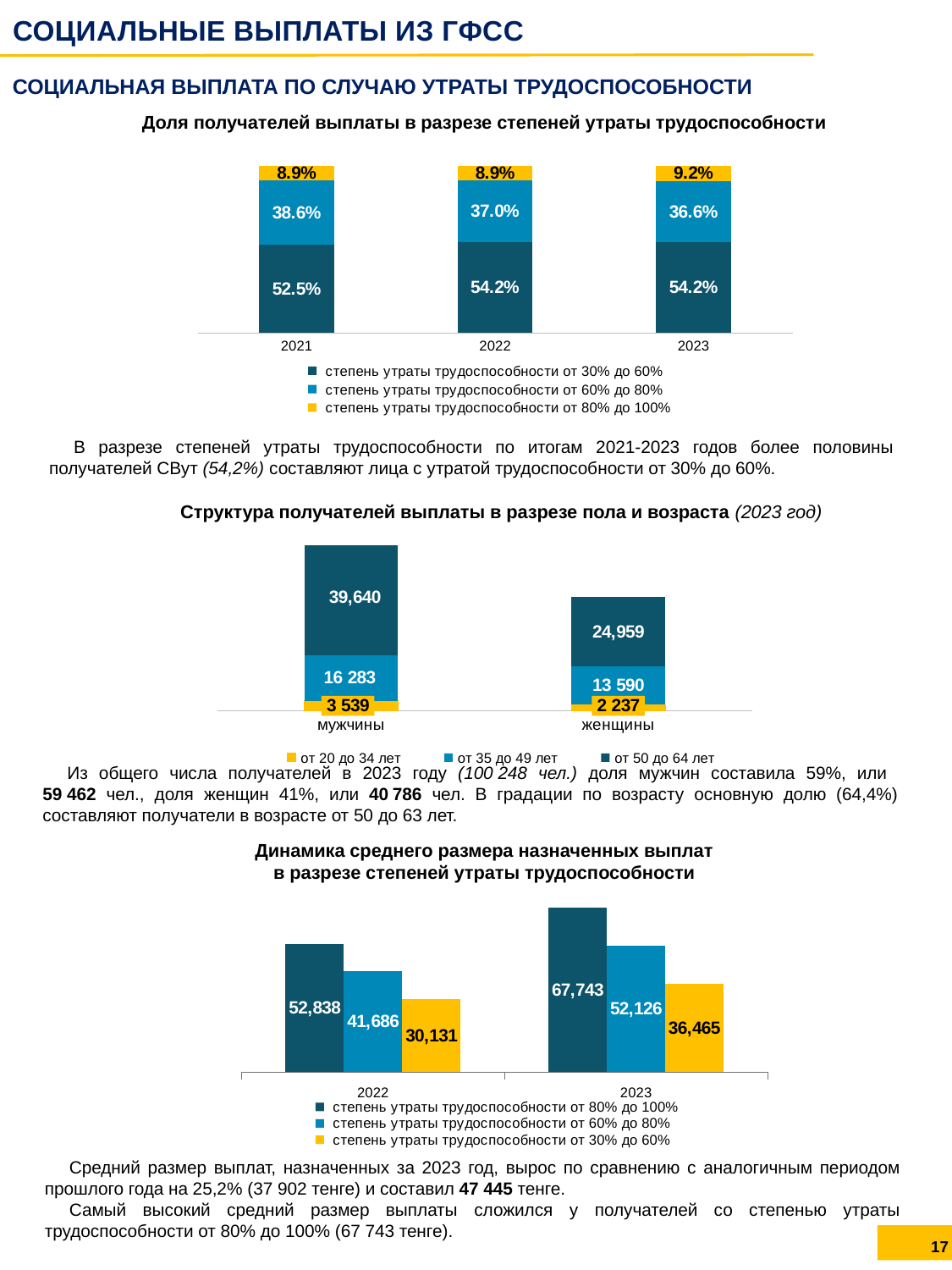
In the chart 'Доля получателей выплаты в разрезе степеней утраты трудоспособности', how many series does the legend list? 3 In the chart 'Доля получателей выплаты в разрезе степеней утраты трудоспособности', what is the share for 'степень утраты трудоспособности от 60% до 80%' in 2021? 38.6% In the chart 'Динамика среднего размера назначенных выплат в разрезе степеней утраты трудоспособности', what is the difference between the 2023 and 2022 values for 'степень утраты трудоспособности от 30% до 60%'? 6,334 In the chart 'Структура получателей выплаты в разрезе пола и возраста (2023 год)', which category has the larger value for 'от 20 до 34 лет', мужчины or женщины? мужчины In the chart 'Доля получателей выплаты в разрезе степеней утраты трудоспособности', what is the share for 'степень утраты трудоспособности от 80% до 100%' in 2023? 9.2% In the chart 'Динамика среднего размера назначенных выплат в разрезе степеней утраты трудоспособности', how many years are shown on the x axis? 2 In the chart 'Структура получателей выплаты в разрезе пола и возраста (2023 год)', what type of chart is shown? Stacked bar chart In the chart 'Динамика среднего размера назначенных выплат в разрезе степеней утраты трудоспособности', what is the value for 'степень утраты трудоспособности от 60% до 80%' in 2023? 52,126 In the chart 'Структура получателей выплаты в разрезе пола и возраста (2023 год)', what is the value for 'от 35 до 49 лет' for женщины? 13 590 In the chart 'Динамика среднего размера назначенных выплат в разрезе степеней утраты трудоспособности', which series has the highest value in 2023? степень утраты трудоспособности от 80% до 100% In the chart 'Доля получателей выплаты в разрезе степеней утраты трудоспособности', what is the difference between the 2022 and 2021 shares for 'степень утраты трудоспособности от 30% до 60%'? 1.7% In the chart 'Структура получателей выплаты в разрезе пола и возраста (2023 год)', what is the value for 'от 50 до 64 лет' for мужчины? 39,640